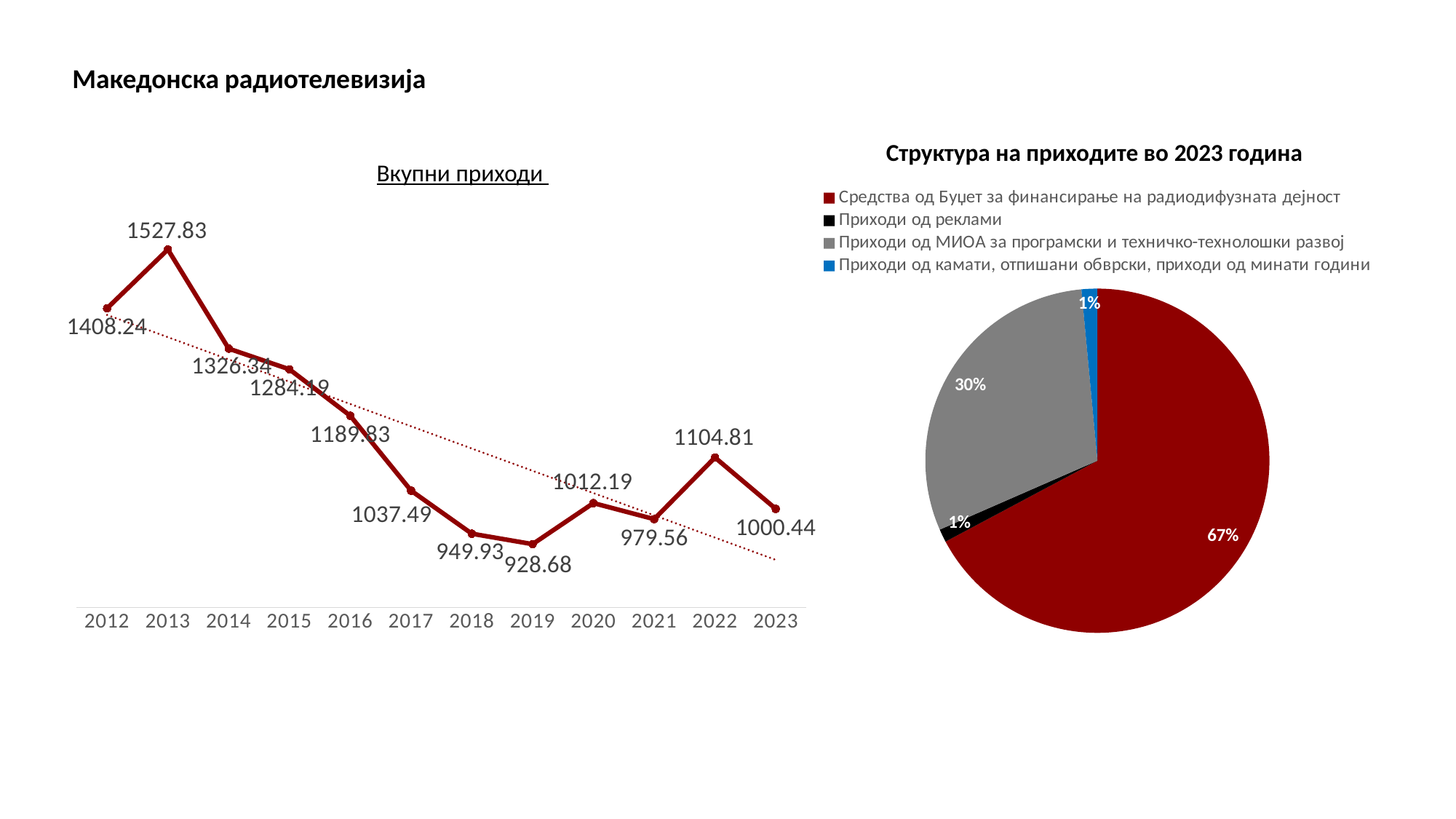
In the 'Вкупни приходи' chart, which is larger, the value for 2016 or the value for 2020? 2016 In the 'Вкупни приходи' chart, do the values generally rise or fall from 2013 to 2019? fall In the 'Вкупни приходи' chart, which year has the highest value? 2013 In the 'Вкупни приходи' chart, what is the difference between the values for 2022 and 2021? 125.25 How many years are plotted in the 'Вкупни приходи' chart? 12 In the 'Вкупни приходи' chart, what is the value for 2013? 1527.83 In the 'Вкупни приходи' chart, which year has the lowest value? 2019 In the pie chart 'Структура на приходите во 2023 година', what share is 'Средства од Буџет за финансирање на радиодифузната дејност'? 67% In the 'Вкупни приходи' chart, what is the value for 2023? 1000.44 What kind of chart is 'Вкупни приходи'? line chart In the pie chart 'Структура на приходите во 2023 година', what share is 'Приходи од МИОА за програмски и техничко-технолошки развој'? 30% How many entries does the legend of the pie chart 'Структура на приходите во 2023 година' list? 4